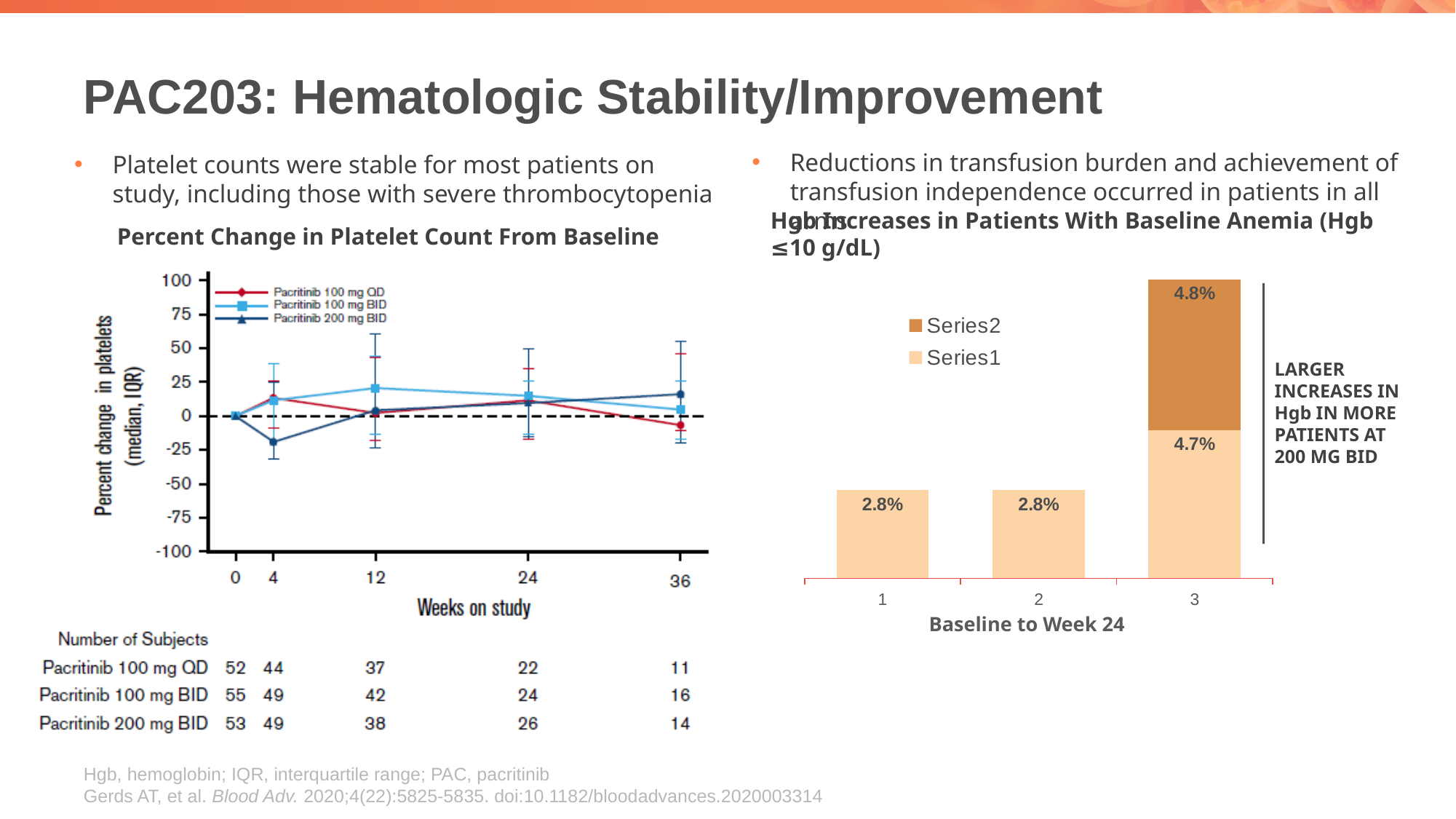
What kind of chart is the 'Hgb Increases in Patients With Baseline Anemia' chart on the right? bar chart What kind of chart is the 'Percent Change in Platelet Count From Baseline' chart on the left? line chart How many series does the legend of the 'Hgb Increases in Patients With Baseline Anemia' chart list? 2 In the 'Percent Change in Platelet Count From Baseline' chart, is the median value for Pacritinib 100 mg BID at week 12 greater or less than 0? greater In the 'Percent Change in Platelet Count From Baseline' chart, is the median value for Pacritinib 200 mg BID at week 4 greater or less than 0? less In the 'Hgb Increases in Patients With Baseline Anemia' chart, which category has the highest total bar? 3 In the 'Hgb Increases in Patients With Baseline Anemia' chart, what is the difference between the Series1 value for category 3 and the Series1 value for category 1? 1.9% In the 'Hgb Increases in Patients With Baseline Anemia' chart, what is the total of the stacked bar for category 3? 9.5% In the 'Hgb Increases in Patients With Baseline Anemia' chart, what is the Series2 value for category 3? 4.8% In the 'Hgb Increases in Patients With Baseline Anemia' chart, what is the Series1 value for category 1? 2.8% How many series does the legend of the 'Percent Change in Platelet Count From Baseline' chart list? 3 In the 'Hgb Increases in Patients With Baseline Anemia' chart, what is the Series1 value for category 3? 4.7%